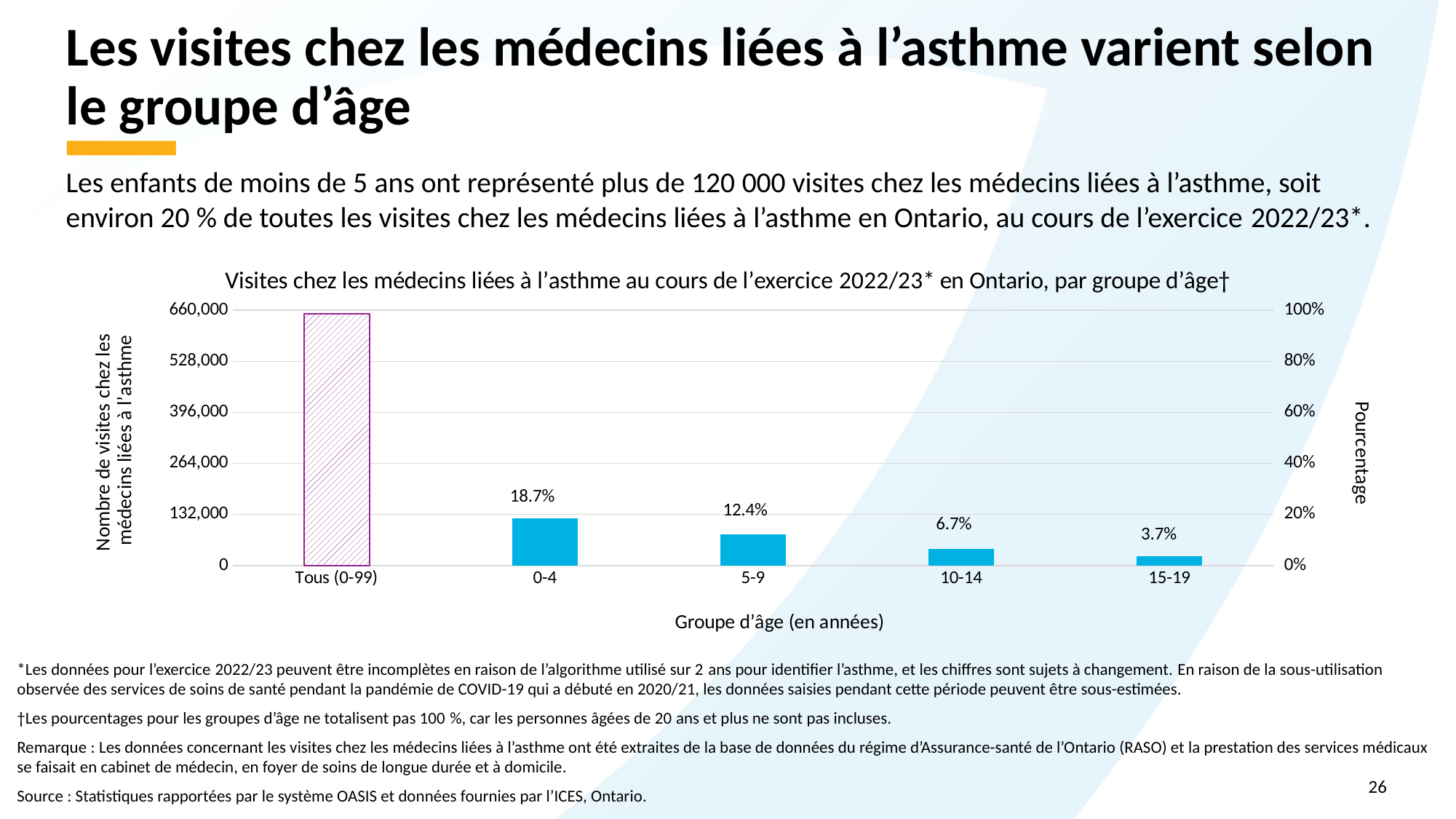
Which has a higher percentage, the 5-9 group or the 10-14 group? 5-9 What is the difference in percentage points between the 0-4 and 5-9 age groups? 6.3 What kind of chart is shown on the slide? bar chart What percentage is shown for the 0-4 age group? 18.7% What percentage is shown for the 10-14 age group? 6.7% How many categories are shown on the x axis? 5 Which bar on the chart is the tallest? Tous (0-99) What percentage is shown for the 15-19 age group? 3.7% What percentage is shown for the 5-9 age group? 12.4% Is the number of visits for Tous (0-99) greater or less than 528,000? greater Do the percentages rise or fall from the 0-4 group to the 15-19 group? fall Which age group has the lowest percentage of asthma-related physician visits? 15-19